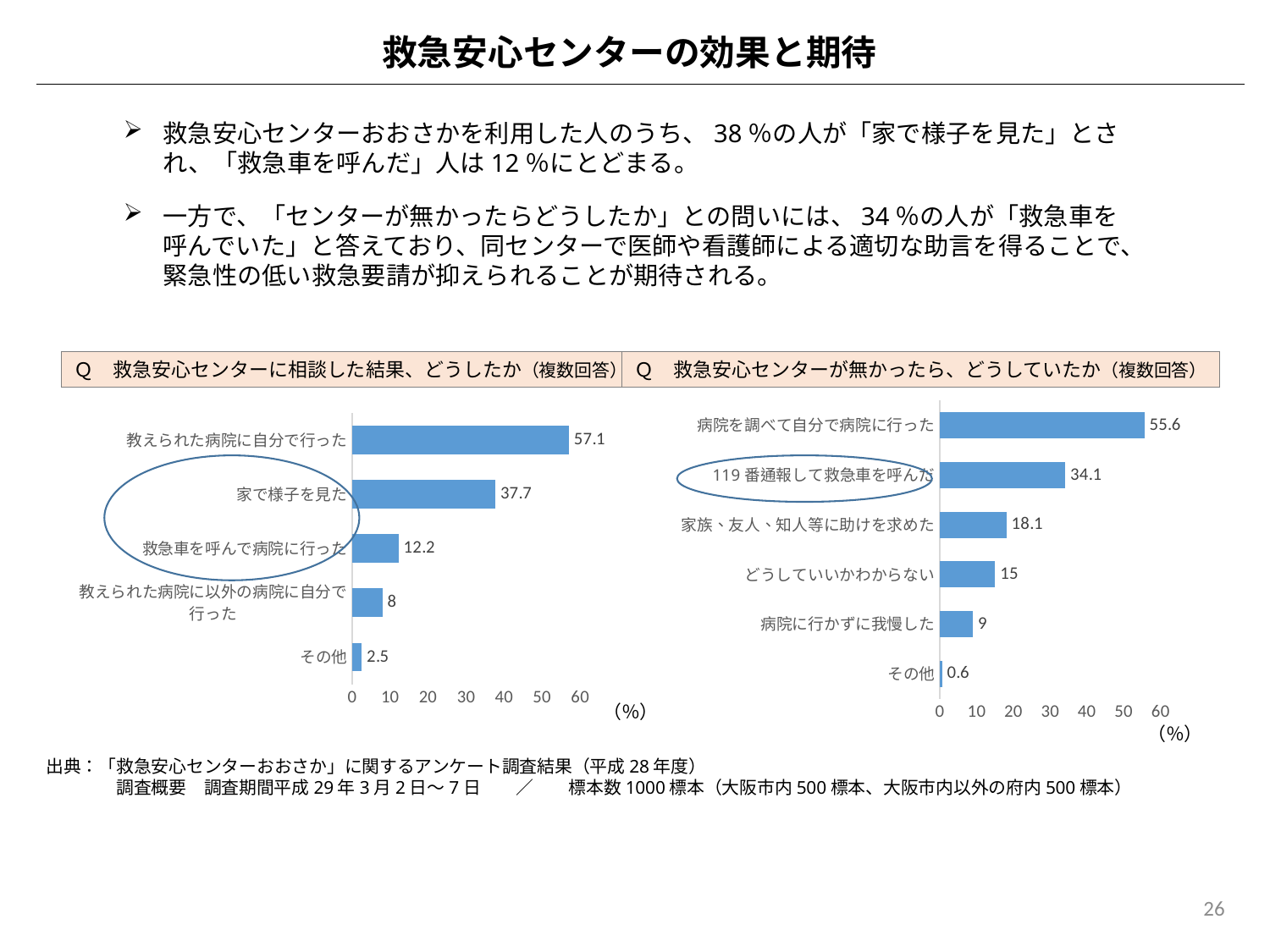
In the left chart (救急安心センターに相談した結果、どうしたか), what is the difference between 教えられた病院に自分で行った and 家で様子を見た? 19.4 What type of chart is the right chart (救急安心センターが無かったら、どうしていたか)? Bar chart In the left chart (救急安心センターに相談した結果、どうしたか), what is the value for 救急車を呼んで病院に行った? 12.2 In the right chart (救急安心センターが無かったら、どうしていたか), how many categories are shown? 6 In the left chart (救急安心センターに相談した結果、どうしたか), which category has the highest value? 教えられた病院に自分で行った In the right chart (救急安心センターが無かったら、どうしていたか), what is the value for 119番通報して救急車を呼んだ? 34.1 In the right chart (救急安心センターが無かったら、どうしていたか), which category has the highest value? 病院を調べて自分で病院に行った In the left chart (救急安心センターに相談した結果、どうしたか), what is the value for 家で様子を見た? 37.7 In the right chart (救急安心センターが無かったら、どうしていたか), which is larger: 家族、友人、知人等に助けを求めた or どうしていいかわからない? 家族、友人、知人等に助けを求めた In the left chart (救急安心センターに相談した結果、どうしたか), how many categories are shown? 5 In the right chart (救急安心センターが無かったら、どうしていたか), what is the value for 病院に行かずに我慢した? 9 In the left chart (救急安心センターに相談した結果、どうしたか), which category has the lowest value? その他